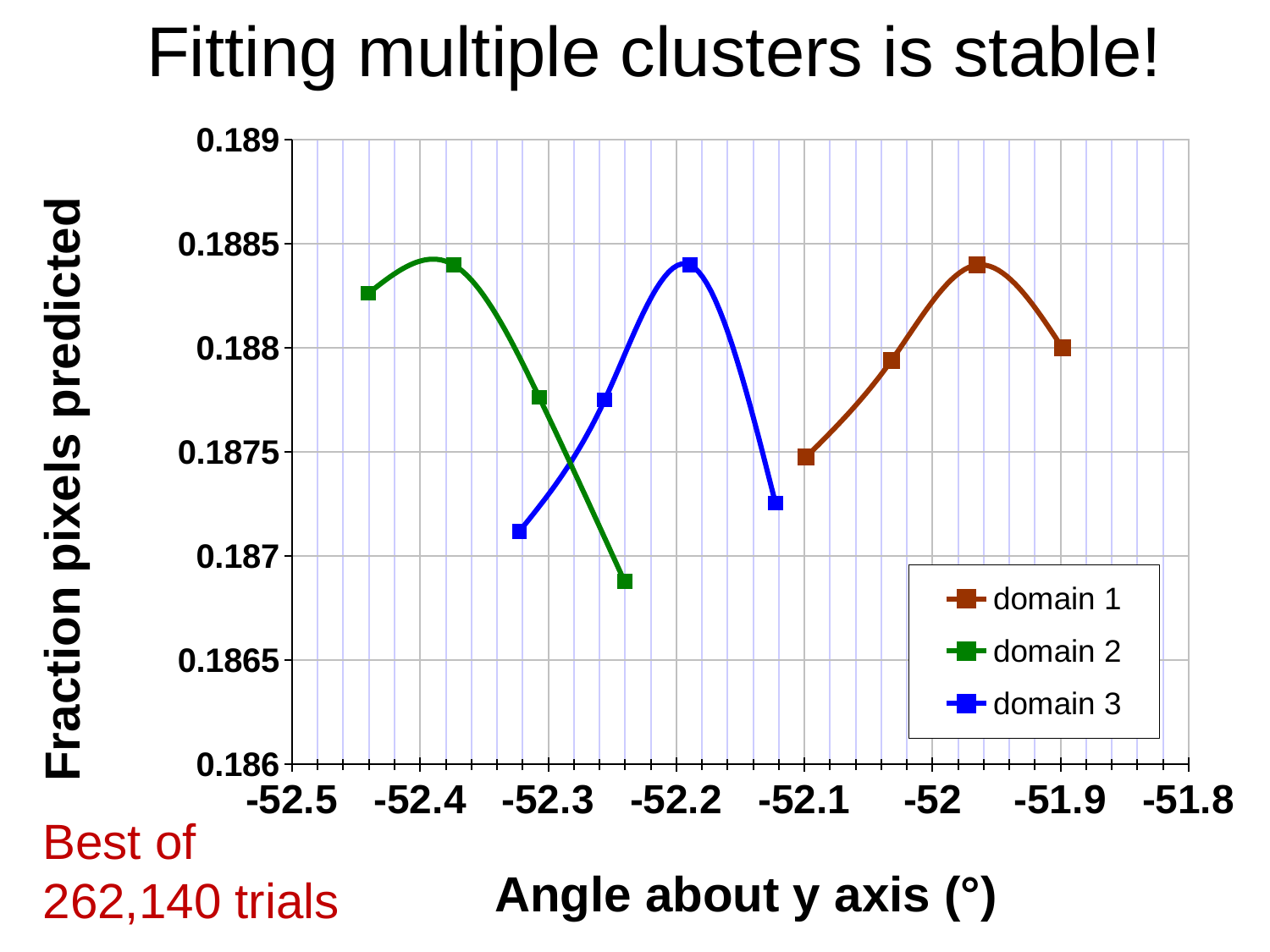
Is the peak value of domain 1 greater or less than 0.188? greater Is the lowest value of domain 2 greater or less than 0.1875? less Is the leftmost point of domain 2 greater or less than 0.188? greater How many data points are plotted for domain 2? 4 How many series does the legend list? 3 What is the label of the x axis? Angle about y axis (°) Which series is plotted furthest to the right along the x axis? domain 1 How many data points are plotted for domain 1? 4 What is the title of the chart? Fitting multiple clusters is stable! What kind of chart is shown on the slide? line chart Which series reaches the lowest value on the chart? domain 2